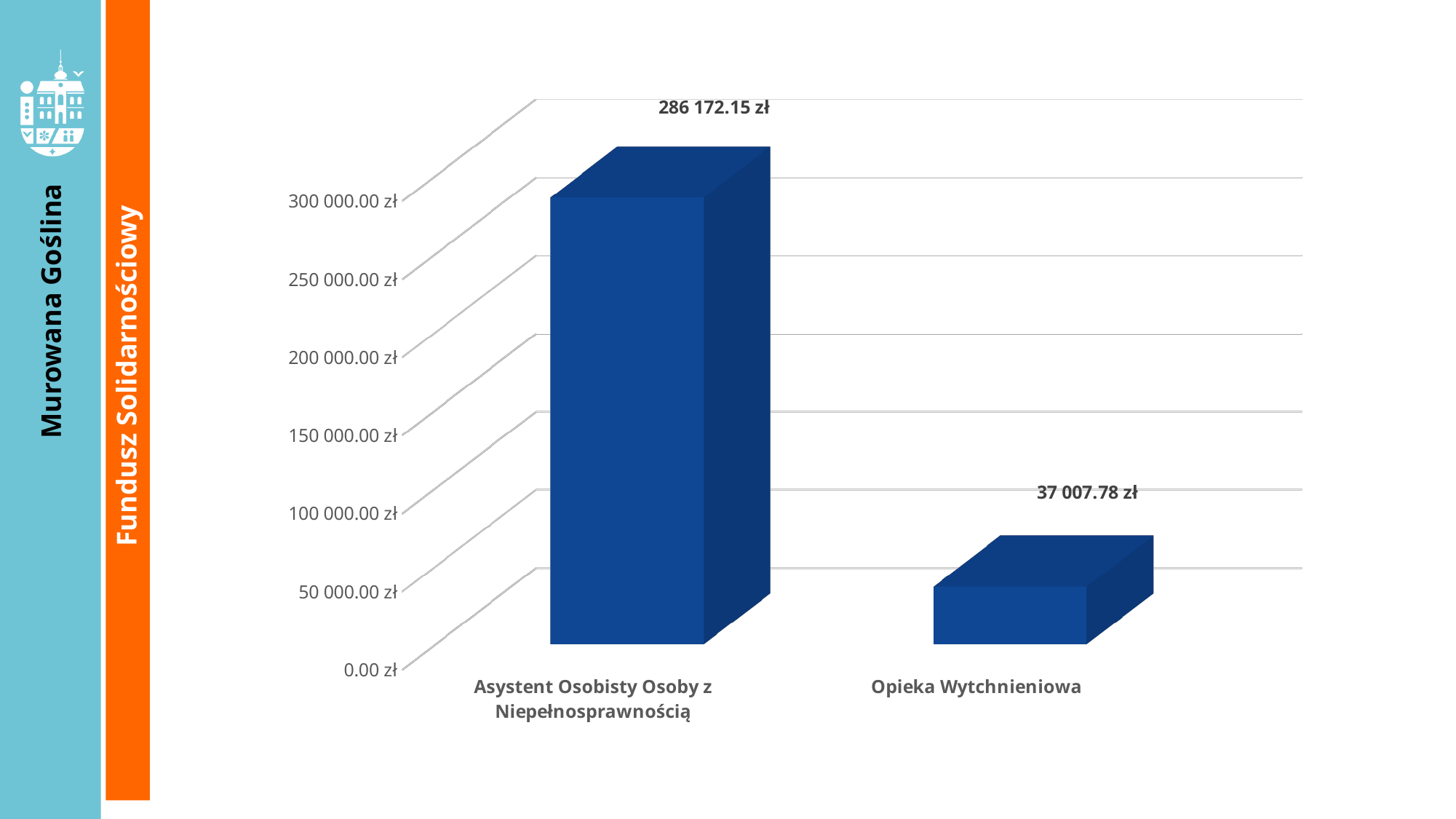
Is the value for Opieka Wytchnieniowa greater or less than 50 000.00 zł? less What colour are the bars in the chart? blue What is the value for Asystent Osobisty Osoby z Niepełnosprawnością? 286 172.15 zł Is the value for Asystent Osobisty Osoby z Niepełnosprawnością greater or less than 250 000.00 zł? greater What is the highest value labelled on the vertical axis? 300 000.00 zł Which category has the lowest value? Opieka Wytchnieniowa Which category has the highest value? Asystent Osobisty Osoby z Niepełnosprawnością What kind of chart is shown on the slide? bar chart What is the difference between the values for Asystent Osobisty Osoby z Niepełnosprawnością and Opieka Wytchnieniowa? 249 164.37 zł Which is larger: the value for Asystent Osobisty Osoby z Niepełnosprawnością or the value for Opieka Wytchnieniowa? Asystent Osobisty Osoby z Niepełnosprawnością What is the value for Opieka Wytchnieniowa? 37 007.78 zł How many categories are shown in the chart? 2